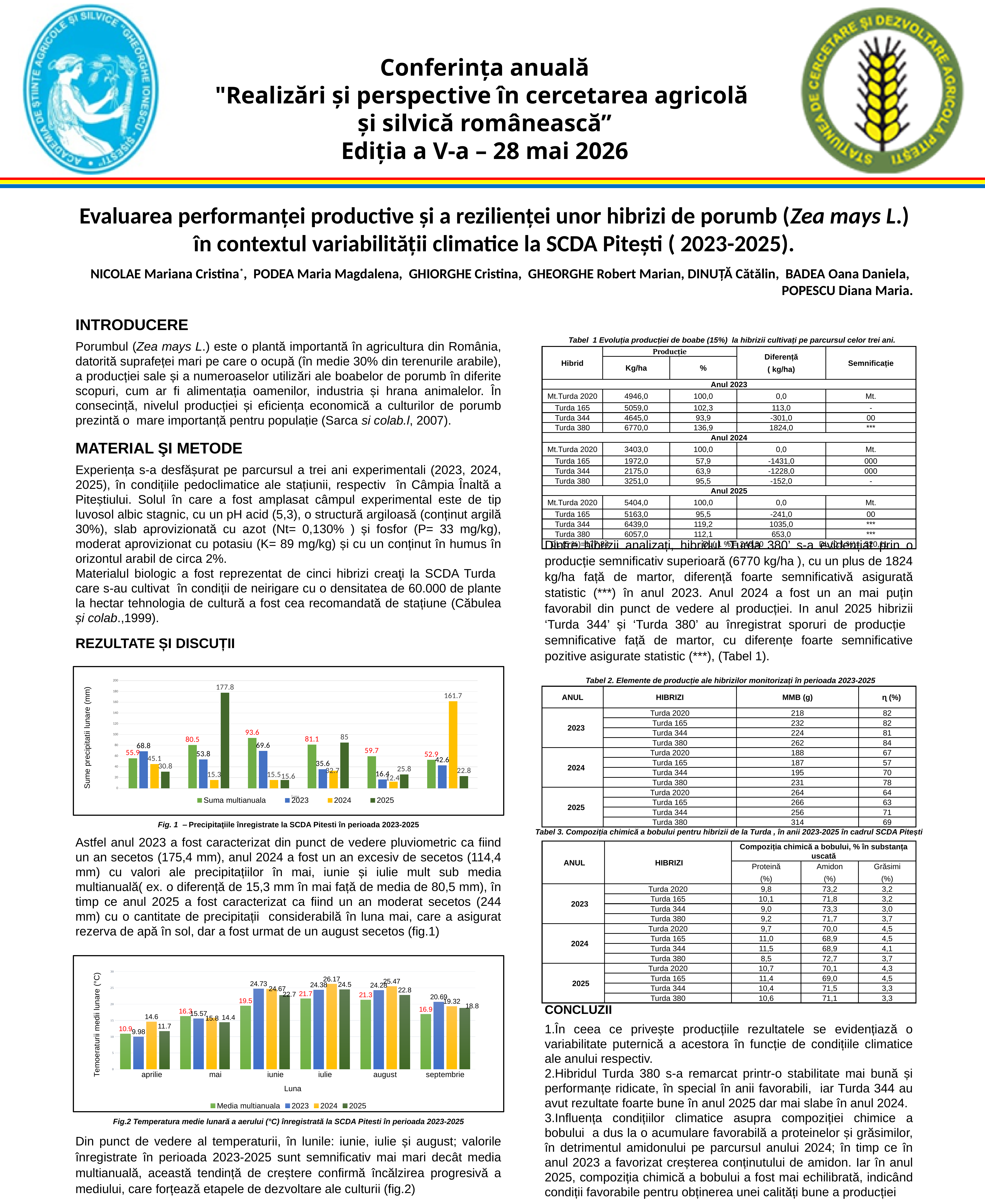
In Fig. 2 (temperature chart), which month has the lowest 2023 value? aprilie In Fig. 2 (temperature chart), how many series does the legend list? 4 In Fig. 2 (temperature chart), how many months are shown on the x axis? 6 In Fig. 2 (temperature chart), what is the 2024 value for iulie? 26.17 What type of chart is Fig. 1 (precipitation chart)? bar chart In Fig. 2 (temperature chart), which month has the highest 2024 value? iulie In Fig. 1 (precipitation chart), what is the highest value plotted for the 2025 series? 177.8 In Fig. 2 (temperature chart), what is the Media multianuala value for aprilie? 10.9 In Fig. 1 (precipitation chart), what is the difference between the Suma multianuala value (80.5) and the 2024 value (15.3) in the second group of bars? 65.2 In Fig. 2 (temperature chart), what is the difference between the 2024 and Media multianuala values for iunie? 5.17 In Fig. 2 (temperature chart), which is larger for septembrie: the 2023 value or the 2024 value? 2023 In Fig. 1 (precipitation chart), what is the highest value plotted for the 2024 series? 161.7